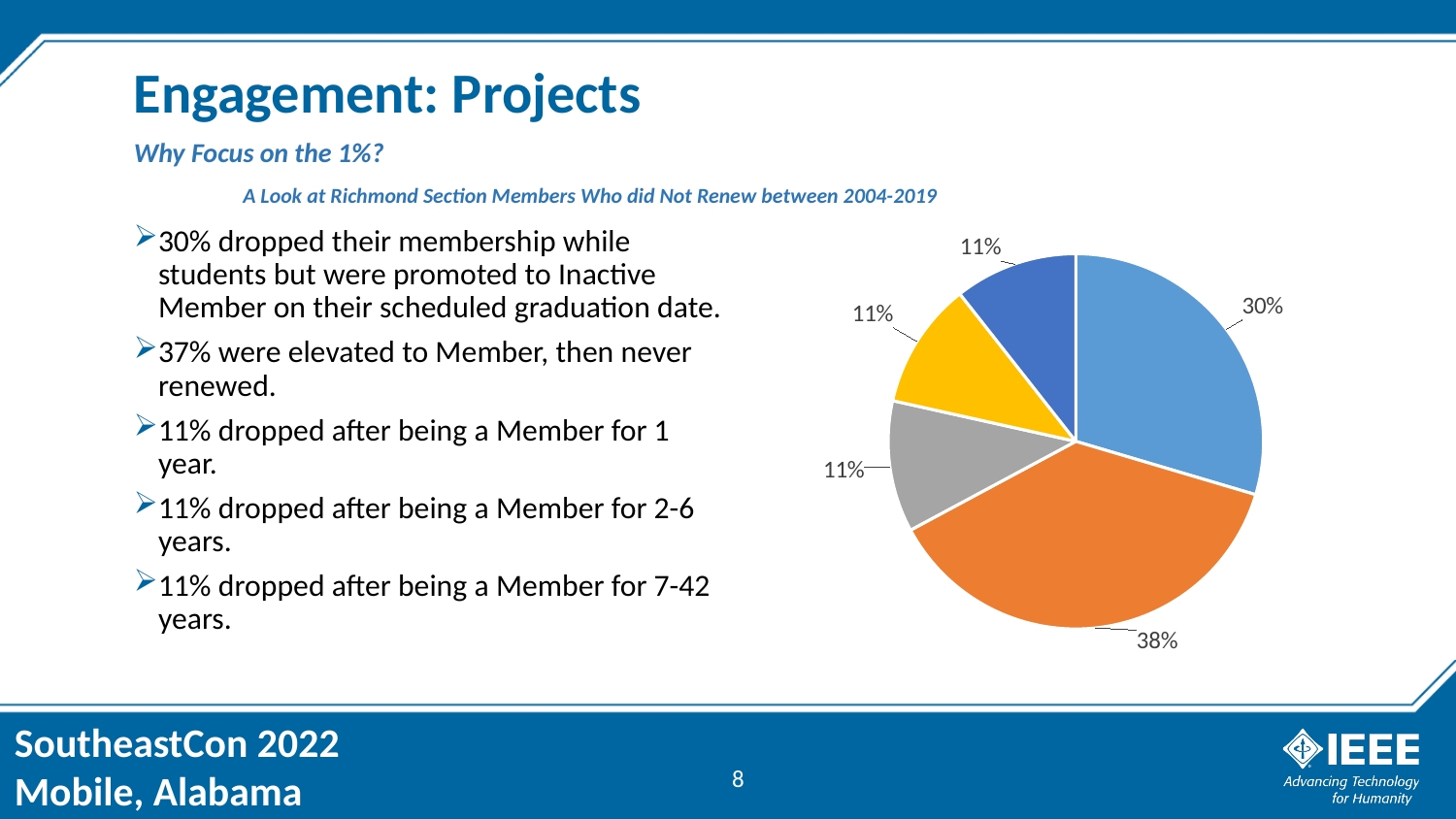
What is the largest percentage shown on the pie chart? 38% What percentage is labelled on the orange slice of the pie chart? 38% What colour is the largest slice of the pie chart? orange How many slices does the pie chart have? 5 What percentage is labelled on the light blue slice of the pie chart? 30% What is the smallest percentage shown on the pie chart? 11% How many slices of the pie chart are labelled 11%? 3 What percentage is labelled on the yellow slice of the pie chart? 11% What is the difference between the largest slice (38%) and the second-largest slice (30%) of the pie chart? 8% What is the combined share of the three slices labelled 11% on the pie chart? 33% What kind of chart is shown on the slide? pie chart Which is larger on the pie chart, the orange slice or the light blue slice? the orange slice